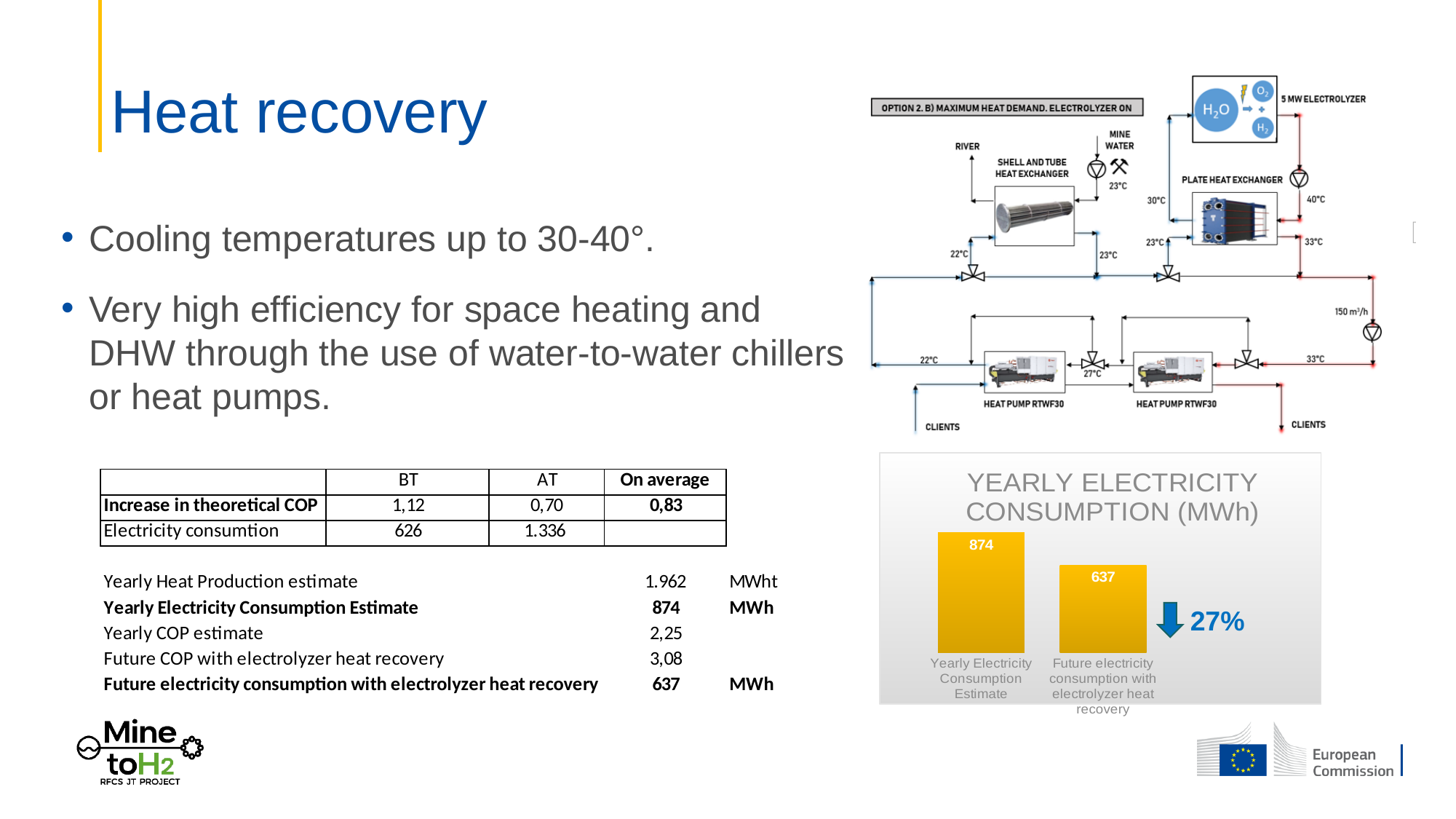
What is the difference between the Yearly Electricity Consumption Estimate and the Future electricity consumption with electrolyzer heat recovery in the chart? 237 In the Yearly Electricity Consumption chart, which is larger: the Yearly Electricity Consumption Estimate or the Future electricity consumption with electrolyzer heat recovery? Yearly Electricity Consumption Estimate Do the values rise or fall from left to right in the Yearly Electricity Consumption chart? Fall What is the value for Future electricity consumption with electrolyzer heat recovery in the Yearly Electricity Consumption chart? 637 What kind of chart is the Yearly Electricity Consumption chart? Bar chart Which category has the lowest value in the Yearly Electricity Consumption chart? Future electricity consumption with electrolyzer heat recovery What unit is given in the title of the Yearly Electricity Consumption chart? MWh What percentage reduction is annotated next to the bars in the Yearly Electricity Consumption chart? 27% What is the title of the bar chart on the slide? YEARLY ELECTRICITY CONSUMPTION (MWh) What is the value for Yearly Electricity Consumption Estimate in the Yearly Electricity Consumption chart? 874 How many bars are shown in the Yearly Electricity Consumption chart? 2 Which category has the highest value in the Yearly Electricity Consumption chart? Yearly Electricity Consumption Estimate